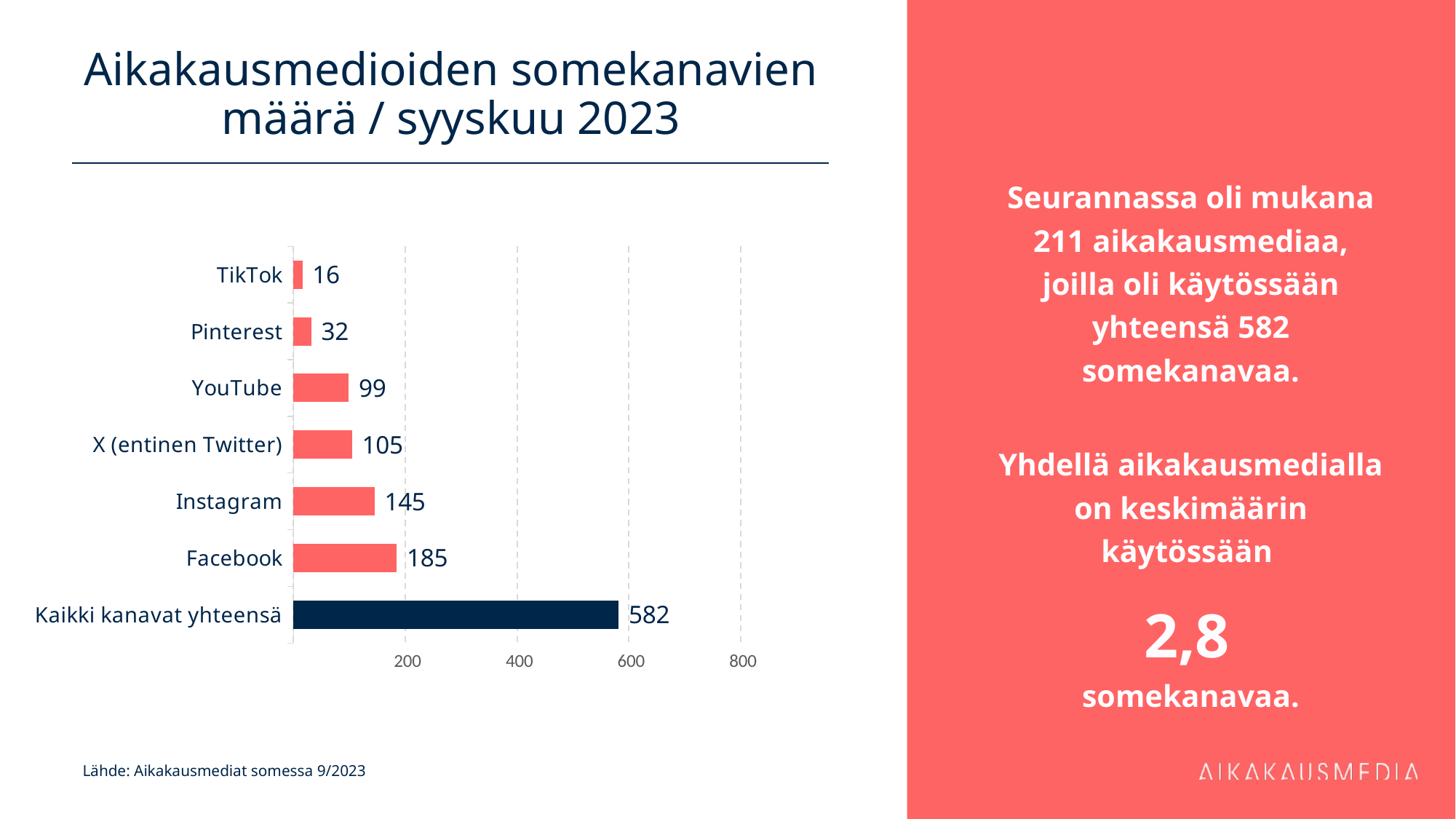
What kind of chart is shown on the slide? Bar chart How many categories are shown in the chart? 7 Which is larger, the value for YouTube or the value for Pinterest? YouTube What is the value for TikTok? 16 What is the value for X (entinen Twitter)? 105 What is the title of the slide? Aikakausmedioiden somekanavien määrä / syyskuu 2023 Which category has the lowest value? TikTok Is the value for Instagram greater or less than 200? less What is the value for Kaikki kanavat yhteensä? 582 What is the value for Facebook? 185 Which individual channel (excluding the total bar) has the highest value? Facebook What is the difference between the values for Facebook and Instagram? 40